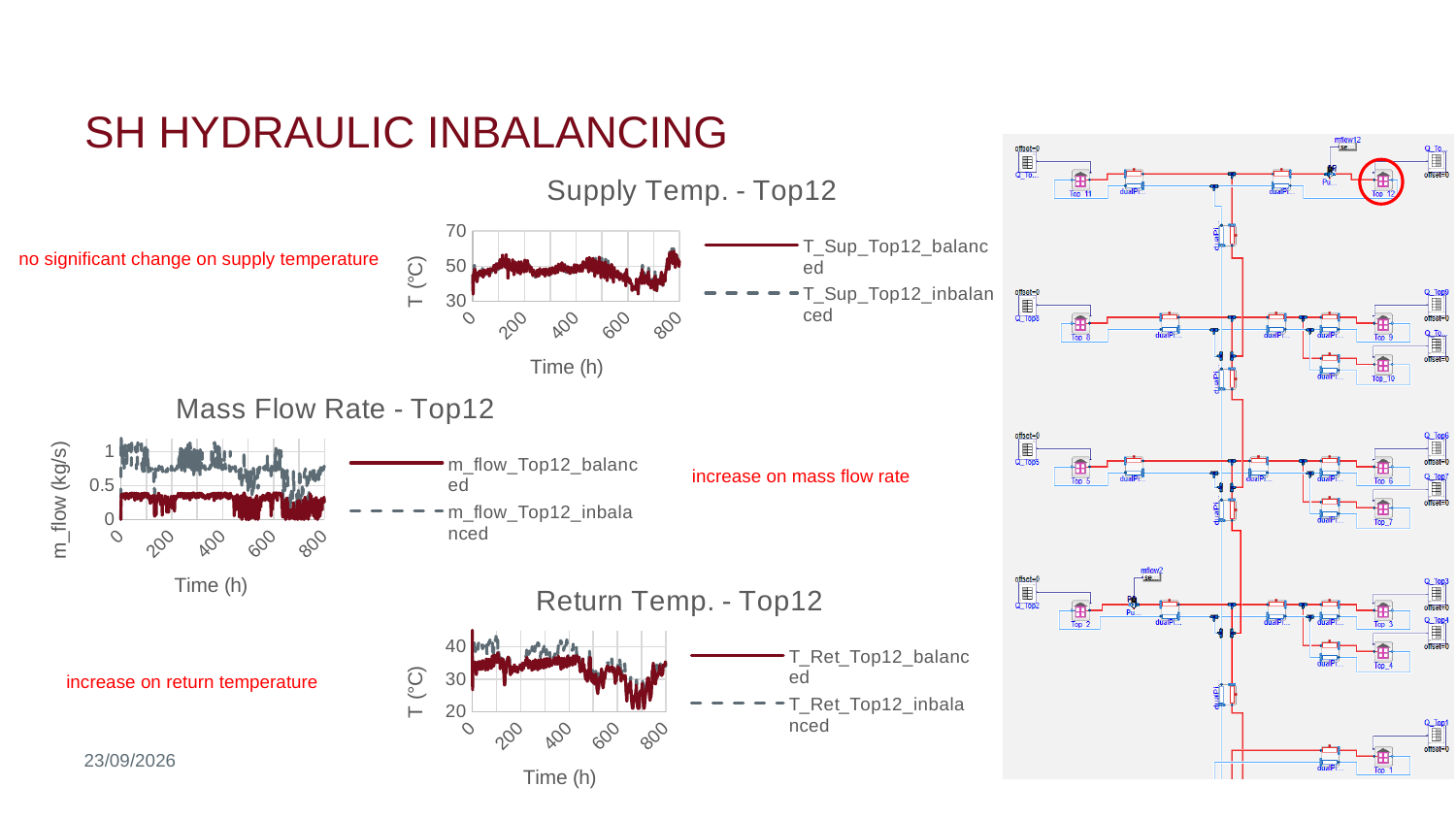
In the "Mass Flow Rate - Top12" chart, which series has the larger value at 200 h, m_flow_Top12_balanced or m_flow_Top12_inbalanced? m_flow_Top12_inbalanced In the "Return Temp. - Top12" chart, is the value of T_Ret_Top12_balanced at 200 h greater or less than 20? greater What is the y-axis label of the "Mass Flow Rate - Top12" chart? m_flow (kg/s) In the "Return Temp. - Top12" chart, is the value of T_Ret_Top12_balanced at 200 h greater or less than 40? less How many series does the legend of the "Return Temp. - Top12" chart list? 2 How many charts are shown on the slide? 3 What is the x-axis label of the "Return Temp. - Top12" chart? Time (h) In the "Supply Temp. - Top12" chart, is the value of T_Sup_Top12_balanced at 200 h greater or less than 30? greater What kind of chart is the "Supply Temp. - Top12" chart? line chart How many series does the legend of the "Mass Flow Rate - Top12" chart list? 2